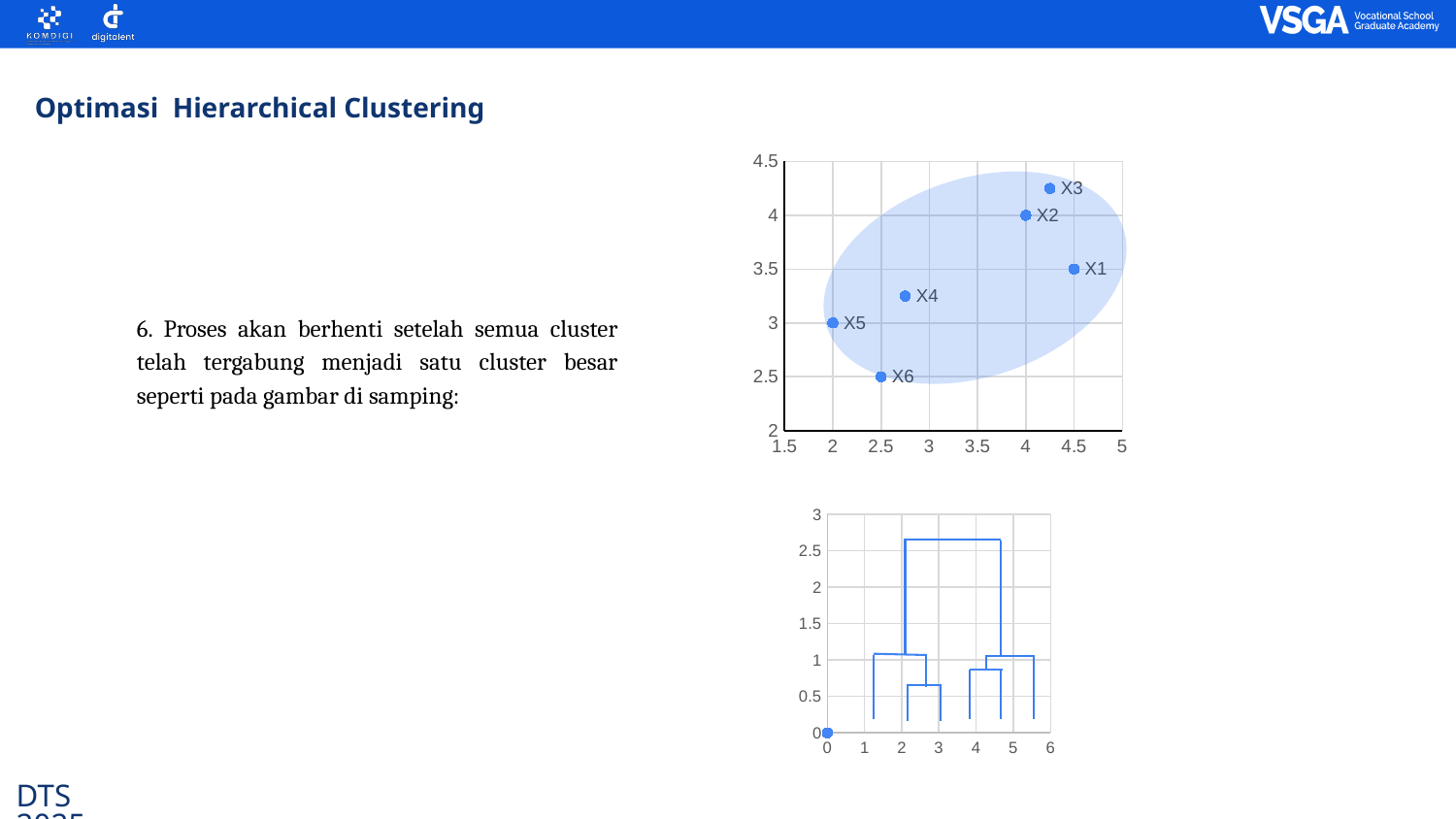
In the bottom dendrogram chart, is the height of the topmost merge greater or less than 2? greater In the top scatter chart, what is the y value of point X6? 2.5 How many data points are plotted in the top scatter chart? 6 In the top scatter chart, is the y value of X4 greater or less than 3? greater In the top scatter chart, what is the y value of point X2? 4 In the top scatter chart, which point has the largest x value? X1 In the top scatter chart, what is the y value of point X5? 3 What kind of chart is the top chart on the slide? scatter chart In the top scatter chart, which point has the lowest y value? X6 In the top scatter chart, what is the x value of point X5? 2 In the top scatter chart, what is the x value of point X1? 4.5 In the top scatter chart, which point has the highest y value? X3